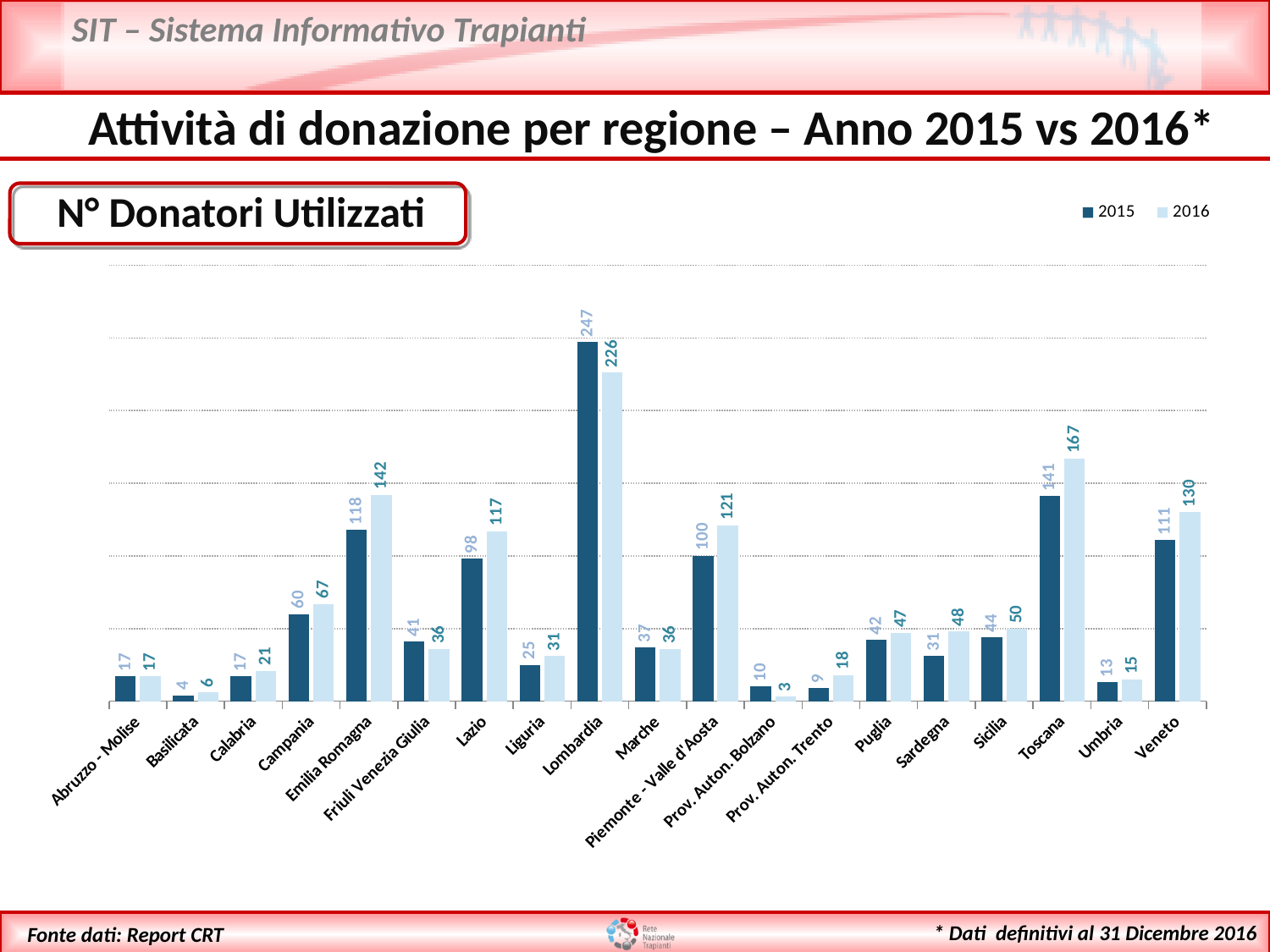
Which region has the highest value in the 2016 series? Lombardia What is the value for Toscana in the 2016 series? 167 Which region has the lowest value in the 2015 series? Basilicata What is the value for Prov. Auton. Bolzano in the 2016 series? 3 Which is larger for Sardegna, the 2015 value or the 2016 value? 2016 What is the difference between the 2016 and 2015 values for Emilia Romagna? 24 What is the value for Lombardia in the 2015 series? 247 What is the difference between the 2015 and 2016 values for Lombardia? 21 Which is larger for Friuli Venezia Giulia, the 2015 value or the 2016 value? 2015 What kind of chart is shown on the slide? Bar chart How many series does the legend list? 2 How many regions are shown on the x axis? 19